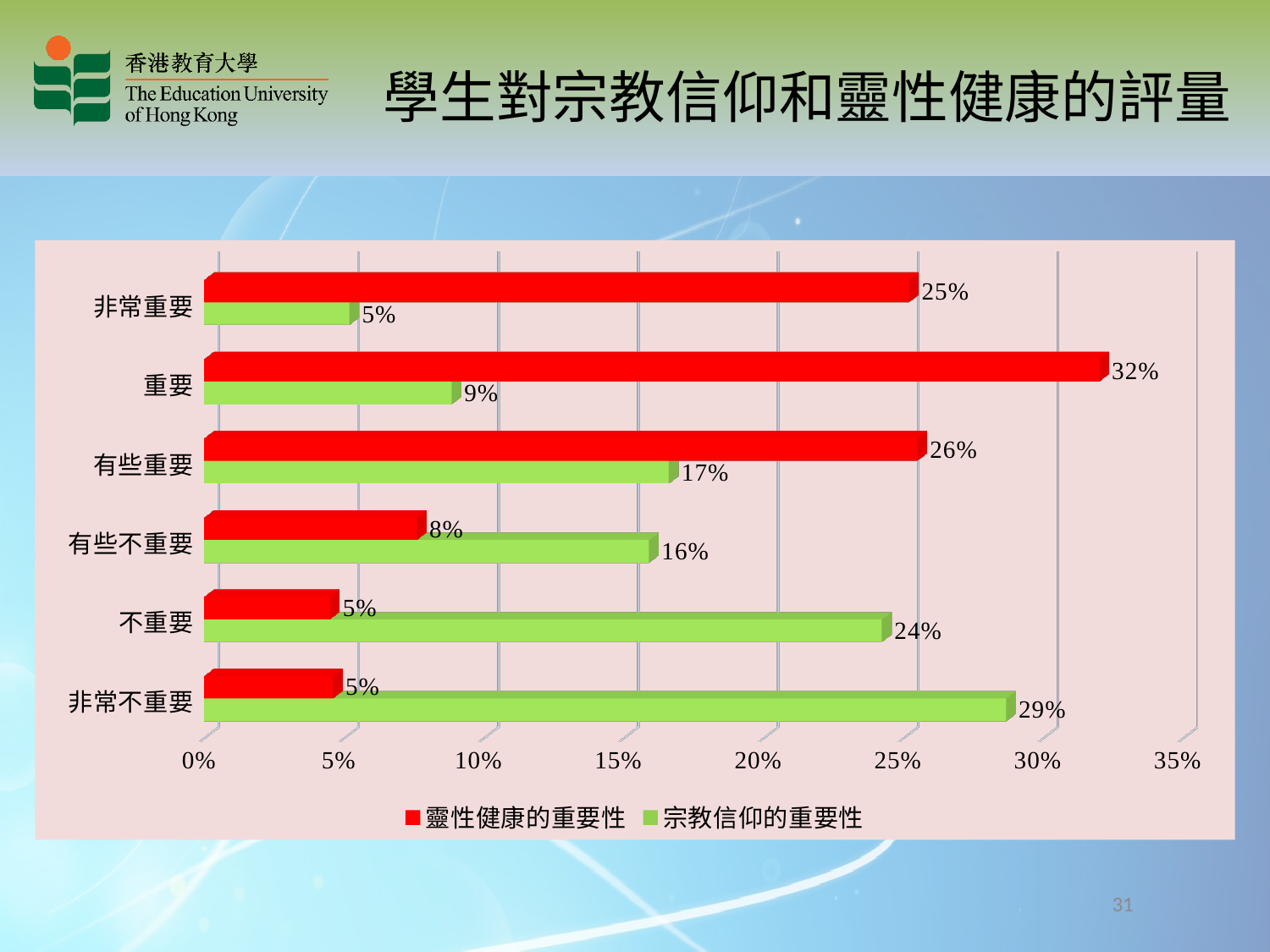
What is the value for 非常不重要 in the 宗教信仰的重要性 series? 29% How many series does the legend list? 2 For 不重要, which series has the larger value, 靈性健康的重要性 or 宗教信仰的重要性? 宗教信仰的重要性 What is the difference between the 靈性健康的重要性 and 宗教信仰的重要性 values for 非常重要? 20% How many categories are shown on the chart? 6 What kind of chart is shown on the slide? bar chart Which colour represents the 宗教信仰的重要性 series? green What is the value for 重要 in the 靈性健康的重要性 series? 32% Which category has the highest value in the 靈性健康的重要性 series? 重要 What is the value for 有些重要 in the 宗教信仰的重要性 series? 17% Which category has the lowest value in the 宗教信仰的重要性 series? 非常重要 Is the value for 有些不重要 in the 宗教信仰的重要性 series greater or less than 10%? greater